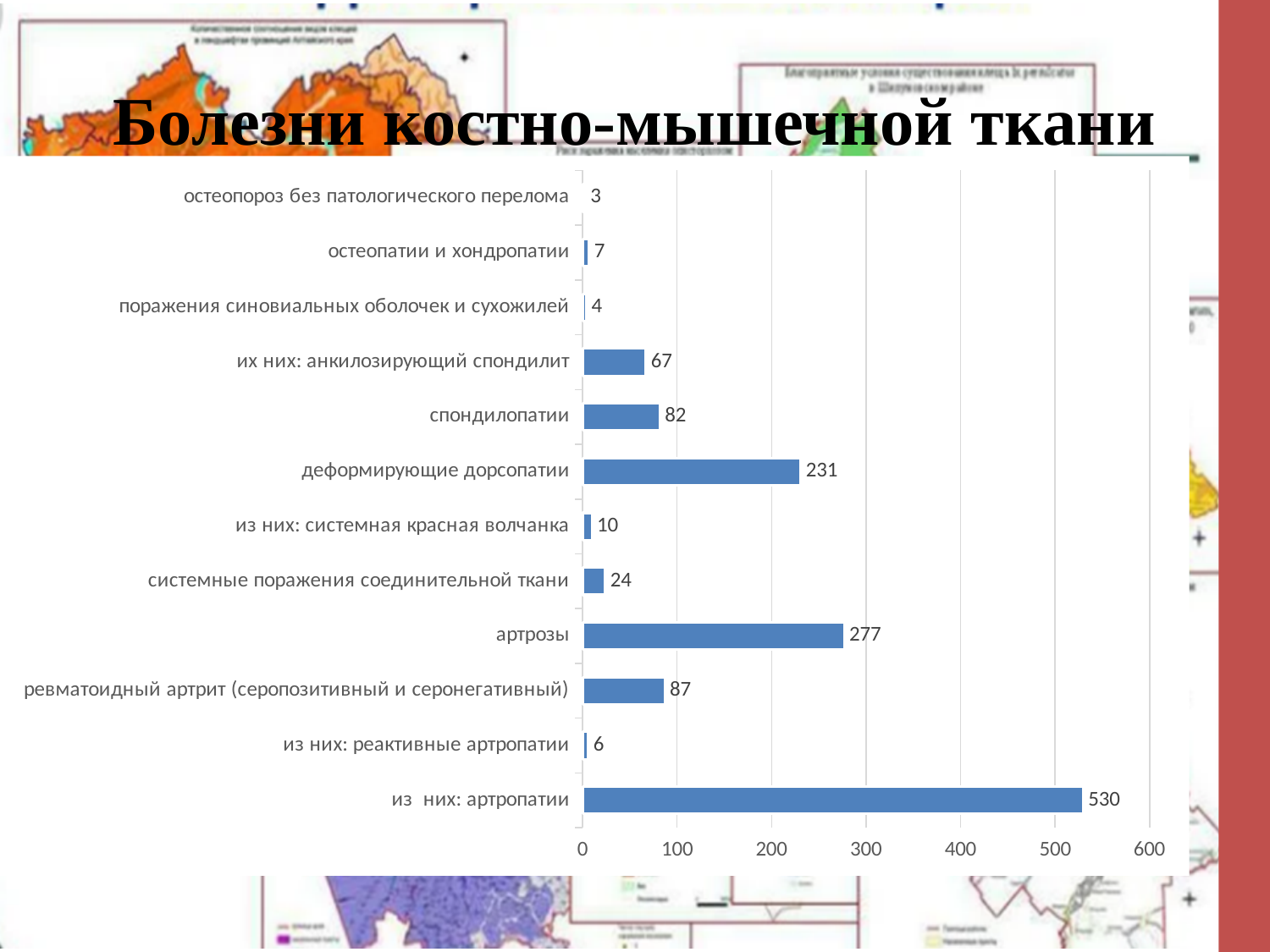
What is the value for деформирующие дорсопатии? 231 What is the difference between the values for из них: артропатии and артрозы? 253 Which is larger, the value for спондилопатии or the value for ревматоидный артрит (серопозитивный и серонегативный)? ревматоидный артрит (серопозитивный и серонегативный) How many categories are shown in the chart? 12 Which category has the lowest value? остеопороз без патологического перелома Which category has the highest value? из них: артропатии What is the value for артрозы? 277 What is the value for спондилопатии? 82 What is the value for их них: анкилозирующий спондилит? 67 Is the value for деформирующие дорсопатии greater or less than 200? greater What is the title of the slide? Болезни костно-мышечной ткани What kind of chart is shown on the slide? bar chart